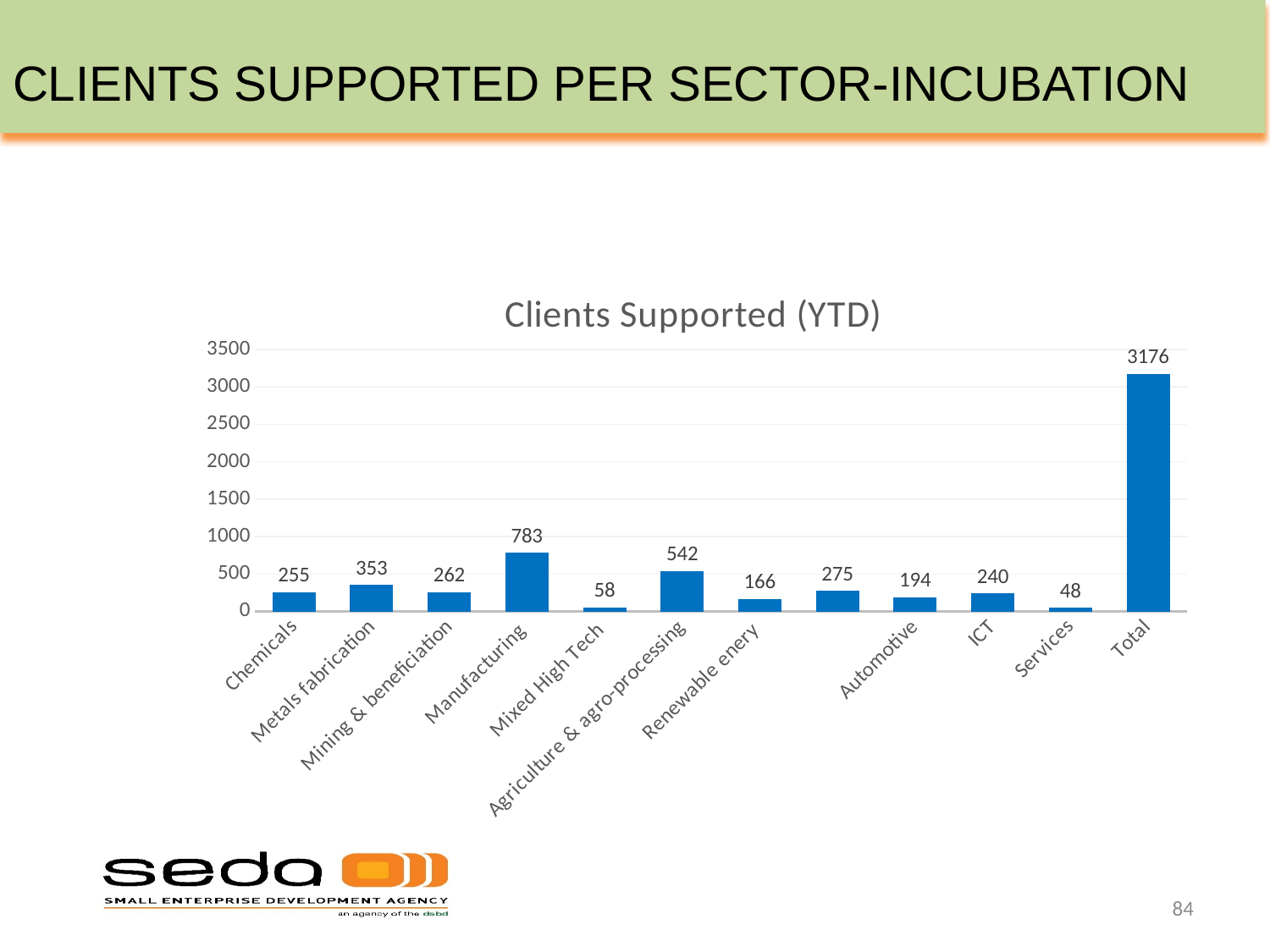
How many bars are plotted in the chart? 12 Which is larger, the value for ICT or the value for Automotive? ICT What is the value for Services? 48 How many clients were supported in the Agriculture & agro-processing sector? 542 Is the value for Mixed High Tech greater or less than 500? less What is the title of the chart? Clients Supported (YTD) Which category has the lowest value in the chart? Services Which sector (excluding the Total bar) has the highest number of clients supported? Manufacturing What type of chart is shown on the slide? Bar chart What is the difference between the values for Metals fabrication and Chemicals? 98 What is the value for Manufacturing in the Clients Supported (YTD) chart? 783 What is the value shown for the Total bar? 3176